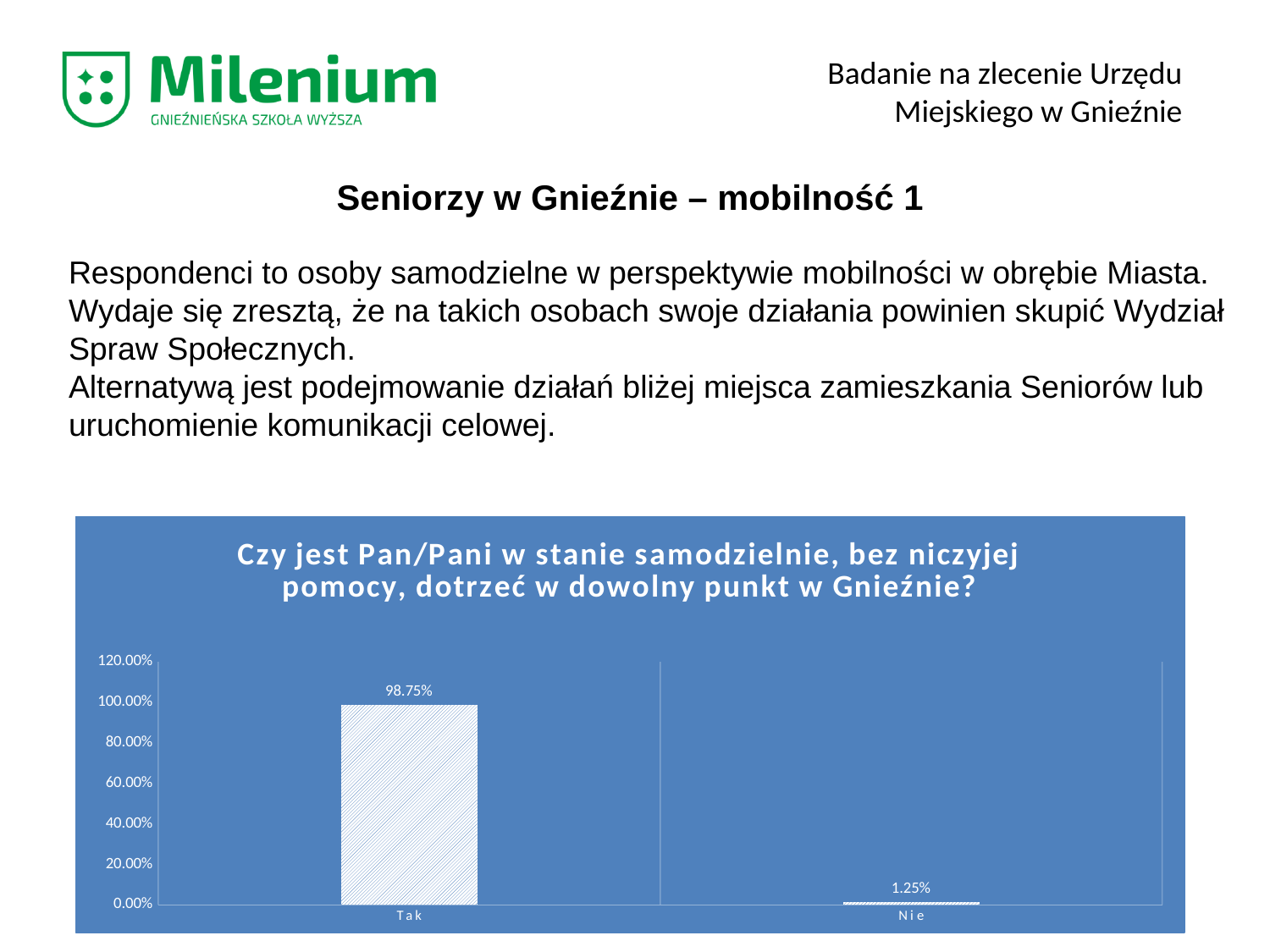
Is the value for "Nie" greater or less than 20.00%? less What is the title of the chart? Czy jest Pan/Pani w stanie samodzielnie, bez niczyjej pomocy, dotrzeć w dowolny punkt w Gnieźnie? What is the difference between the values for "Tak" and "Nie"? 97.50% What kind of chart is shown on the slide? bar chart What is the value for "Tak"? 98.75% What is the highest value shown on the y axis? 120.00% Which is larger, the value for "Tak" or the value for "Nie"? Tak Which category has the highest value? Tak Is the value for "Tak" greater or less than 80.00%? greater How many categories are shown on the x axis? 2 What is the value for "Nie"? 1.25% Which category has the lowest value? Nie